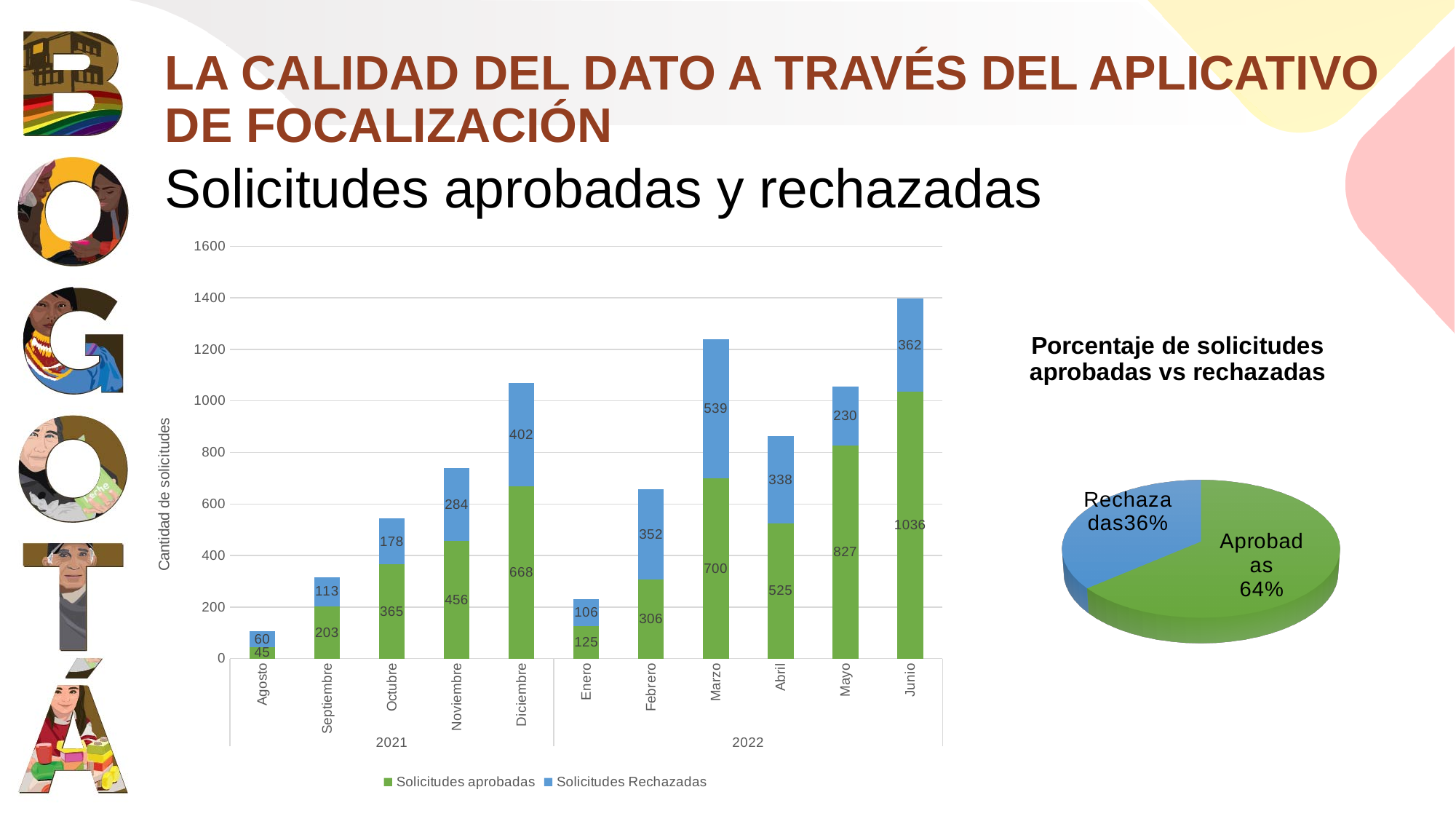
What kind of chart is 'Solicitudes aprobadas y rechazadas'? Stacked bar chart In the bar chart 'Solicitudes aprobadas y rechazadas', which month has the highest number of Solicitudes aprobadas? Junio In the bar chart 'Solicitudes aprobadas y rechazadas', how many months are shown on the x axis? 11 In the bar chart 'Solicitudes aprobadas y rechazadas', how many Solicitudes Rechazadas were there in Diciembre 2021? 402 What is the label of the y axis of the bar chart 'Solicitudes aprobadas y rechazadas'? Cantidad de solicitudes How many series does the legend of the bar chart 'Solicitudes aprobadas y rechazadas' list? 2 In the bar chart 'Solicitudes aprobadas y rechazadas', how many Solicitudes aprobadas were there in Marzo 2022? 700 In the bar chart 'Solicitudes aprobadas y rechazadas', which month has the lowest number of Solicitudes aprobadas? Agosto In the bar chart 'Solicitudes aprobadas y rechazadas', what is the difference between Solicitudes aprobadas and Solicitudes Rechazadas in Mayo 2022? 597 In the bar chart 'Solicitudes aprobadas y rechazadas', which is larger in Febrero 2022: Solicitudes aprobadas or Solicitudes Rechazadas? Solicitudes Rechazadas In the pie chart 'Porcentaje de solicitudes aprobadas vs rechazadas', what share of solicitudes were Aprobadas? 64% In the bar chart 'Solicitudes aprobadas y rechazadas', what is the total height of the stacked bar for Junio 2022? 1398